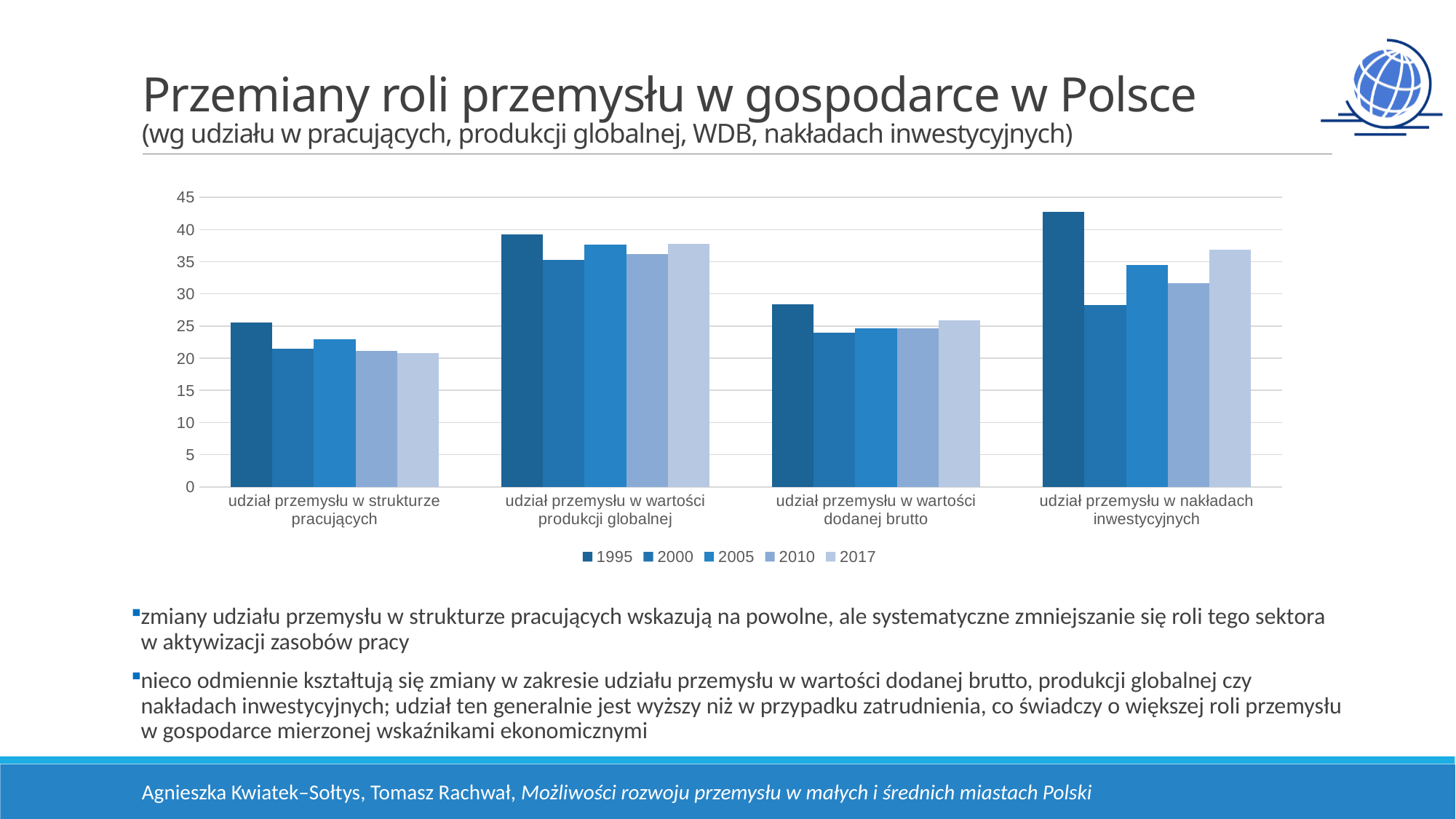
Is the 1995 value for udział przemysłu w nakładach inwestycyjnych greater or less than 40? greater Within udział przemysłu w nakładach inwestycyjnych, which year has the highest value? 1995 What kind of chart is shown on the slide? bar chart What is the first entry in the chart legend? 1995 For udział przemysłu w nakładach inwestycyjnych, which is larger: the 2005 value or the 2010 value? 2005 Is the 2017 value for udział przemysłu w strukturze pracujących greater or less than 25? less How many categories are shown on the x axis? 4 Is the 2000 value for udział przemysłu w wartości dodanej brutto greater or less than 25? less Which category has the highest value for 1995? udział przemysłu w nakładach inwestycyjnych For udział przemysłu w wartości produkcji globalnej, which is larger: the 1995 value or the 2000 value? 1995 Which category has the lowest value for 2017? udział przemysłu w strukturze pracujących How many series does the legend list? 5